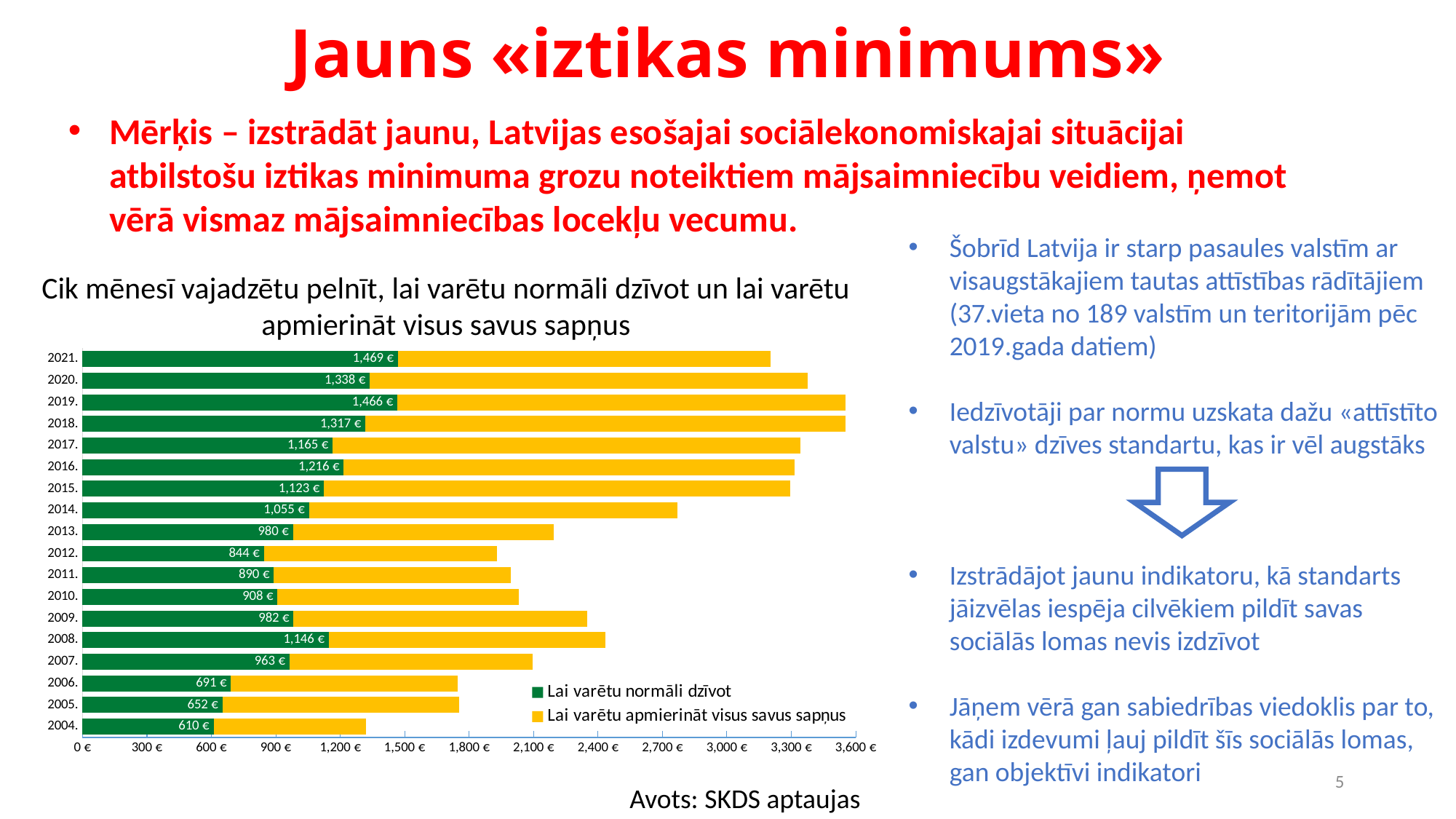
What is the value of 'Lai varētu normāli dzīvot' for 2004? 610 € Which is larger, the 'Lai varētu normāli dzīvot' value for 2008 or for 2009? 2008 Which year has the lowest value for 'Lai varētu normāli dzīvot'? 2004 Is the total length of the 2019 bar greater or less than 3,300 €? greater Is the total length of the 2004 bar greater or less than 1,500 €? less What is the difference between the 'Lai varētu normāli dzīvot' values for 2021 and 2020? 131 € How many years are shown in the chart? 18 What is the value of 'Lai varētu normāli dzīvot' for 2012? 844 € What is the value of 'Lai varētu normāli dzīvot' for 2021? 1,469 € Which colour represents 'Lai varētu apmierināt visus savus sapņus' in the chart? Yellow What kind of chart is shown on the slide? Stacked bar chart How many series does the legend list? 2